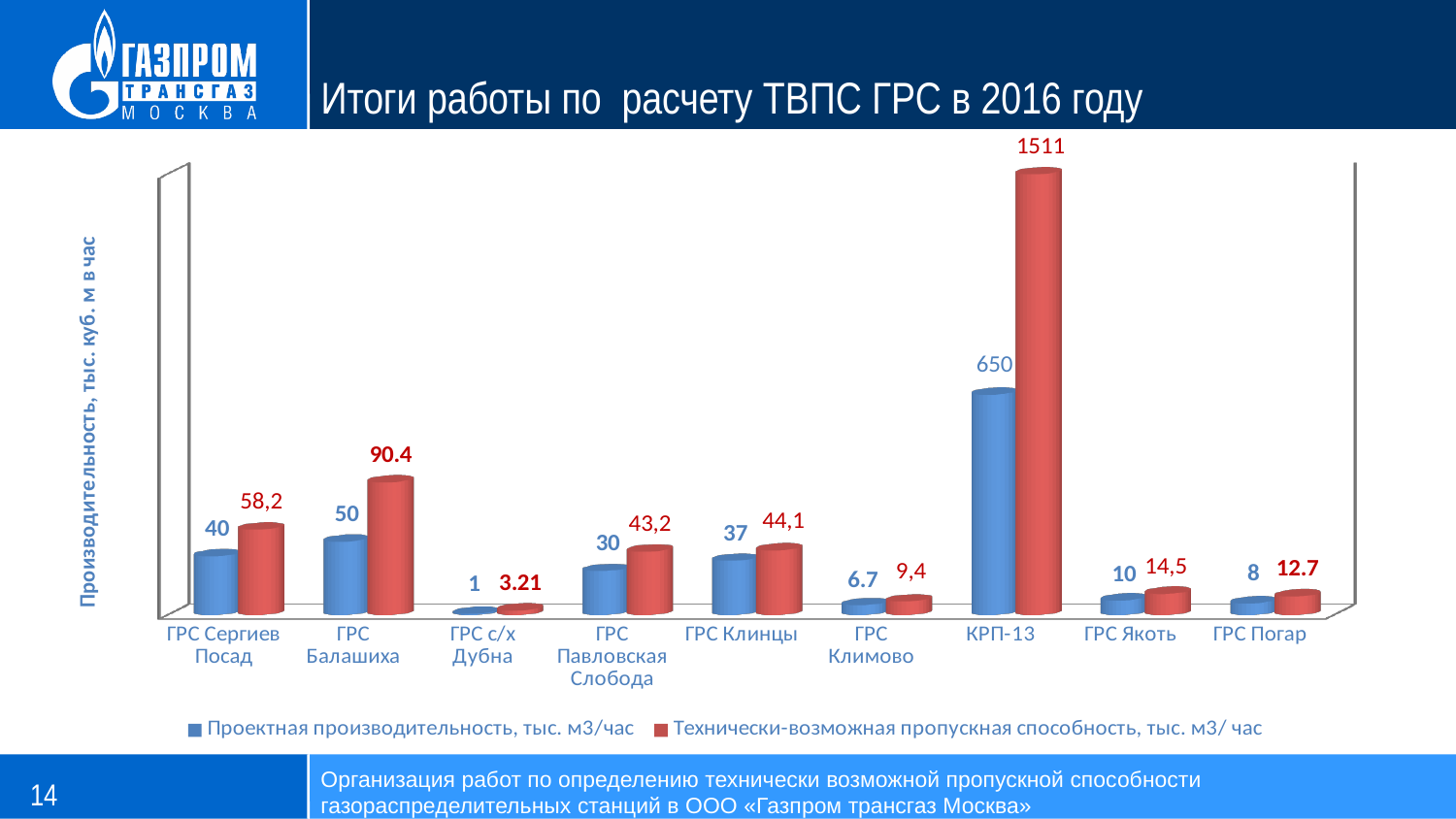
What is the Проектная производительность value for ГРС Балашиха? 50 How many categories are shown on the x axis? 9 What kind of chart is shown on the slide? Bar chart What is the difference between the Технически-возможная пропускная способность and the Проектная производительность for ГРС Балашиха? 40.4 What is the Проектная производительность value for ГРС Климово? 6.7 What is the Технически-возможная пропускная способность value for ГРС Сергиев Посад? 58,2 Which is larger: the Проектная производительность for ГРС Клинцы or for ГРС Павловская Слобода? ГРС Клинцы What is the Технически-возможная пропускная способность value for КРП-13? 1511 How many series does the legend list? 2 Which category has the lowest Технически-возможная пропускная способность? ГРС с/х Дубна Which category has the highest Проектная производительность? КРП-13 What is the label of the vertical axis? Производительность, тыс. куб. м в час